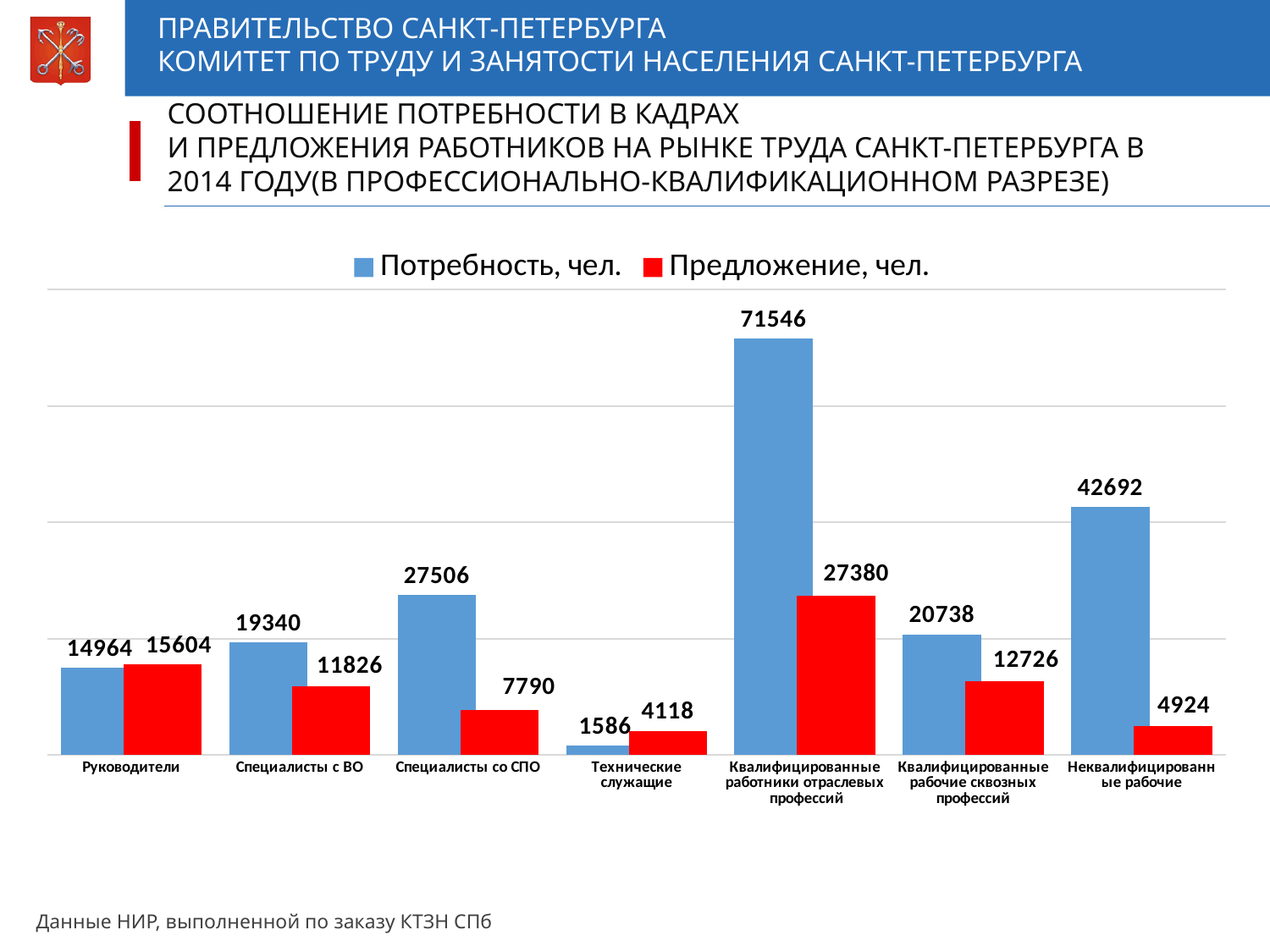
What is the difference between Потребность, чел. and Предложение, чел. for Квалифицированные работники отраслевых профессий? 44166 What is the value of Потребность, чел. for Руководители? 14964 Which category has the lowest value for Предложение, чел.? Технические служащие What is the value of Предложение, чел. for Технические служащие? 4118 What is the value of Предложение, чел. for Специалисты со СПО? 7790 How many categories are shown on the x axis? 7 What is the difference between Потребность, чел. and Предложение, чел. for Неквалифицированные рабочие? 37768 Which colour represents the series Предложение, чел. in the legend? Red How many series does the legend list? 2 Which category has the highest value for Потребность, чел.? Квалифицированные работники отраслевых профессий What type of chart is shown on the slide? Bar chart Which is larger for Руководители: Потребность, чел. or Предложение, чел.? Предложение, чел.